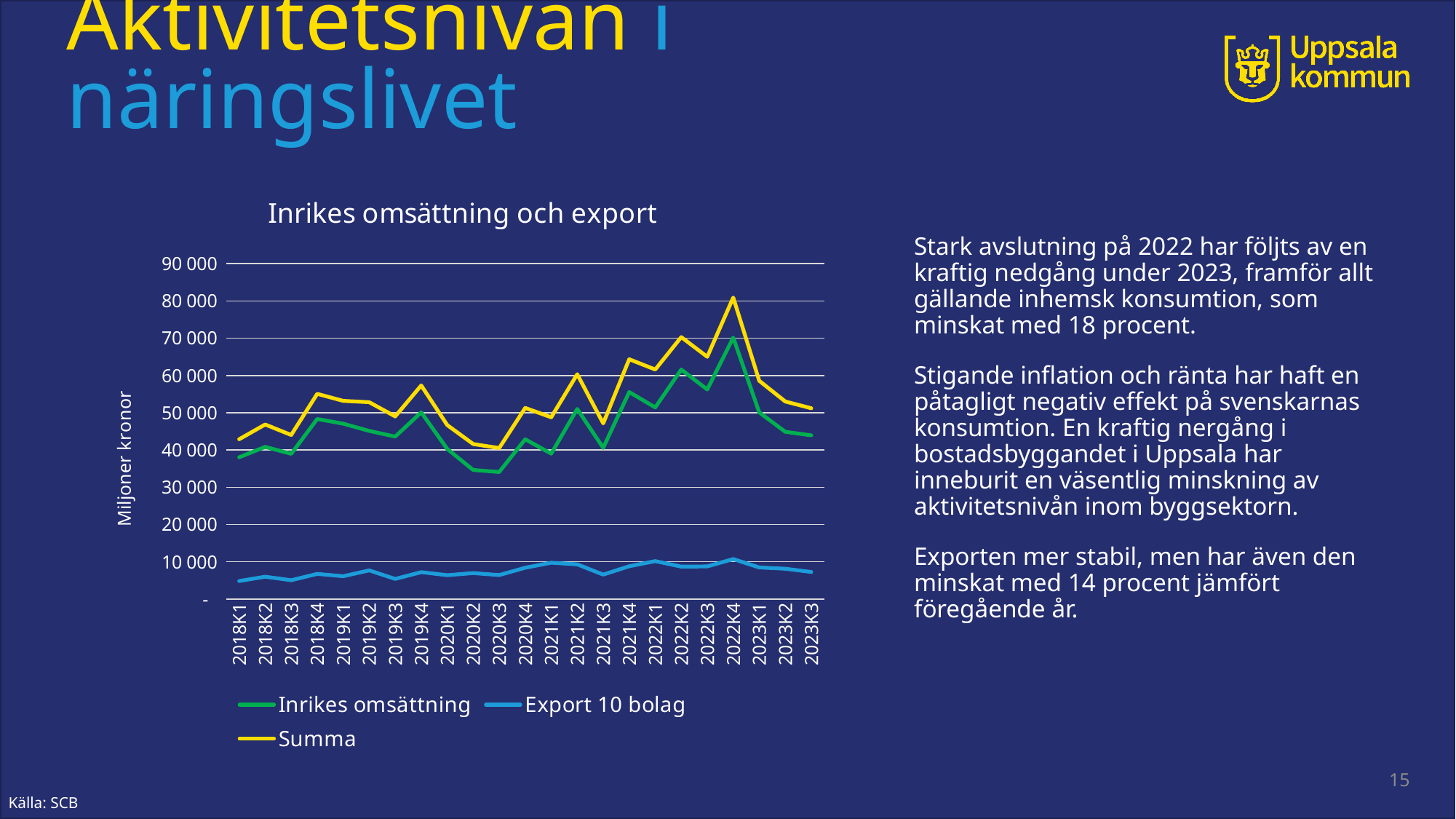
Which is larger for Inrikes omsättning: the value in 2022K4 or the value in 2023K3? 2022K4 What kind of chart is shown on the slide? Line chart In which quarter does the Summa series reach its highest value? 2022K4 Which is larger in 2023K3: Inrikes omsättning or Export 10 bolag? Inrikes omsättning In which quarter does the Inrikes omsättning series reach its highest value? 2022K4 Is the value for Export 10 bolag in 2023K3 greater or less than 10 000? less How many quarters are plotted along the x axis of the chart? 23 Does the Inrikes omsättning series rise or fall from 2022K4 to 2023K3? Fall How many series does the legend of the chart list? 3 Is the value for Inrikes omsättning in 2020K2 greater or less than 40 000? less What is the label on the y axis of the chart? Miljoner kronor Is the value for Summa in 2022K4 greater or less than 70 000? greater